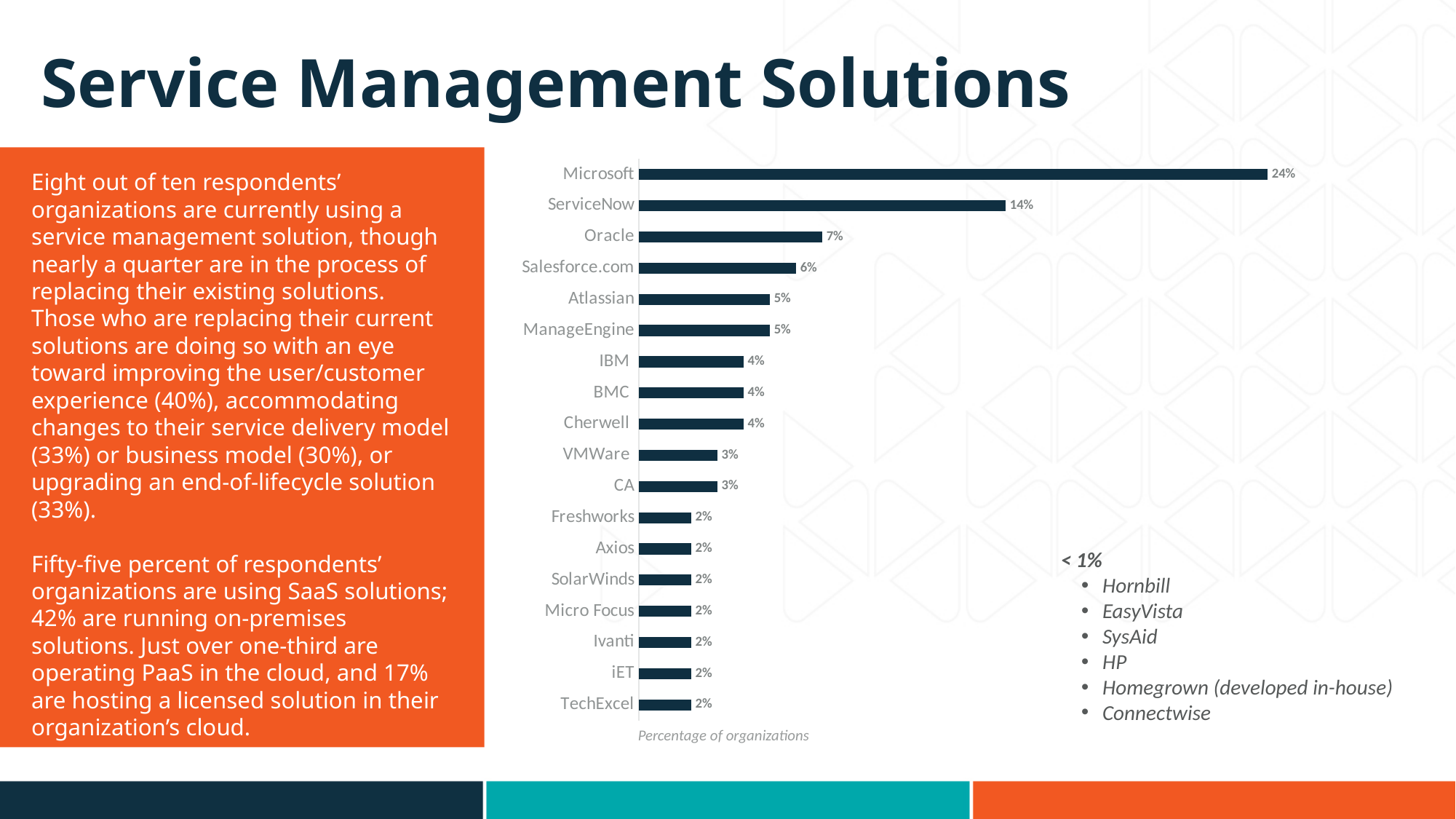
What is the value shown for ServiceNow? 14% Which vendor has the highest percentage of organizations? Microsoft What percentage is shown for Salesforce.com? 6% What is the difference in percentage points between Microsoft and ServiceNow? 10% What type of chart is shown on the slide? Bar chart Which has a larger value, Oracle or IBM? Oracle What is the axis label shown beneath the chart? Percentage of organizations What is the difference between Oracle and Atlassian? 2% What percentage of organizations use Microsoft as their service management solution? 24% What is the value shown for Cherwell? 4% How many vendors are plotted as bars in the chart? 18 Which has a larger value, ServiceNow or Salesforce.com? ServiceNow